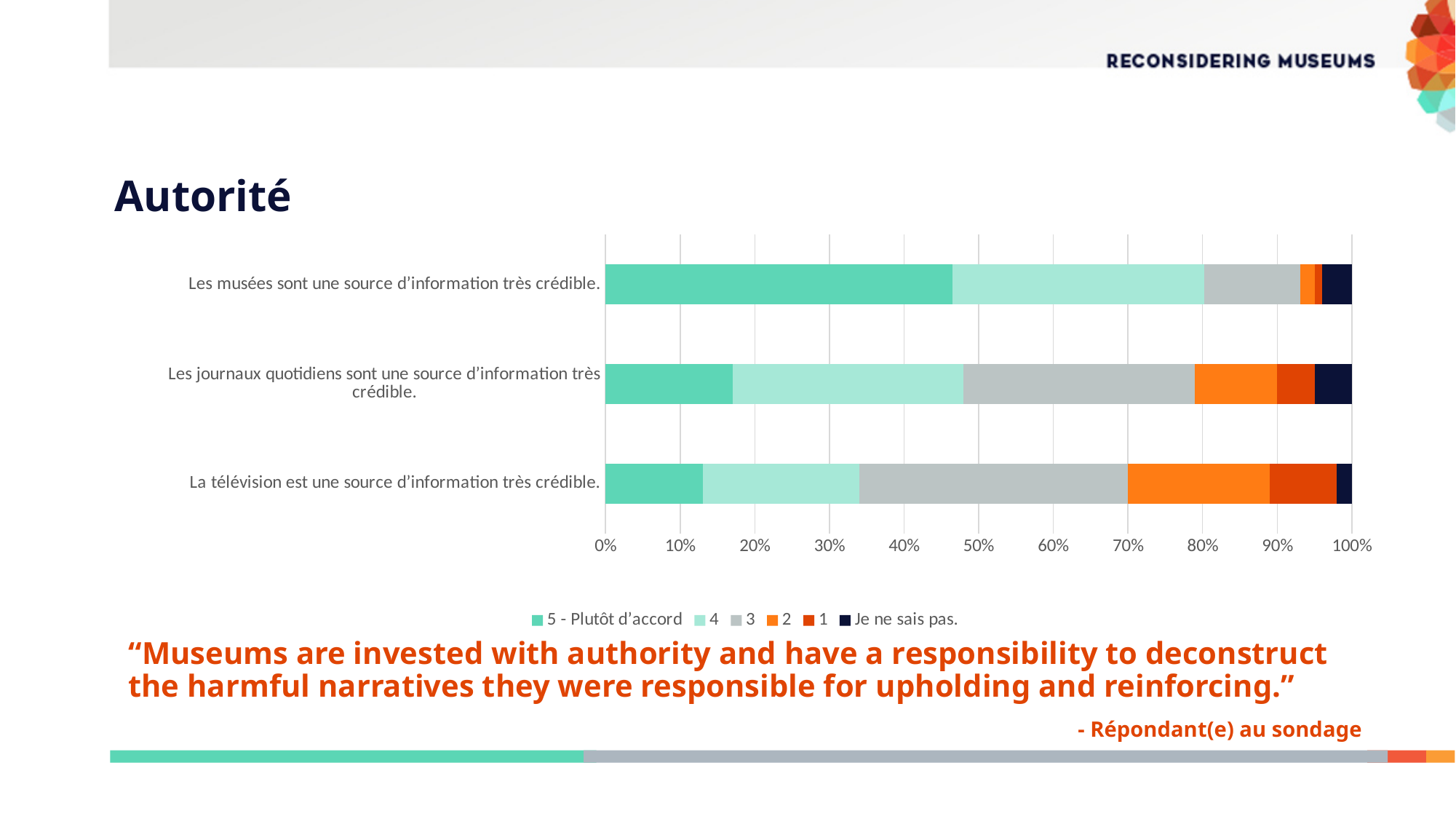
Which statement has the largest '5 - Plutôt d'accord' segment? Les musées sont une source d'information très crédible. What is the title of the slide containing the chart? Autorité Is the '5 - Plutôt d'accord' value for 'La télévision est une source d'information très crédible.' greater or less than 20%? less What kind of chart is shown on the slide? Stacked bar chart Which statement has the smallest '5 - Plutôt d'accord' segment? La télévision est une source d'information très crédible. Is the 'Je ne sais pas.' value for 'Les musées sont une source d'information très crédible.' greater or less than 10%? less Which statement has a larger '3' segment: 'La télévision est une source d'information très crédible.' or 'Les musées sont une source d'information très crédible.'? La télévision est une source d'information très crédible. Is the '5 - Plutôt d'accord' value for 'Les musées sont une source d'information très crédible.' greater or less than 40%? greater How many statements (categories) are plotted in the chart? 3 How many series does the chart legend list? 6 What is the first entry in the chart legend? 5 - Plutôt d'accord Which statement has a larger '1' segment: 'La télévision est une source d'information très crédible.' or 'Les musées sont une source d'information très crédible.'? La télévision est une source d'information très crédible.